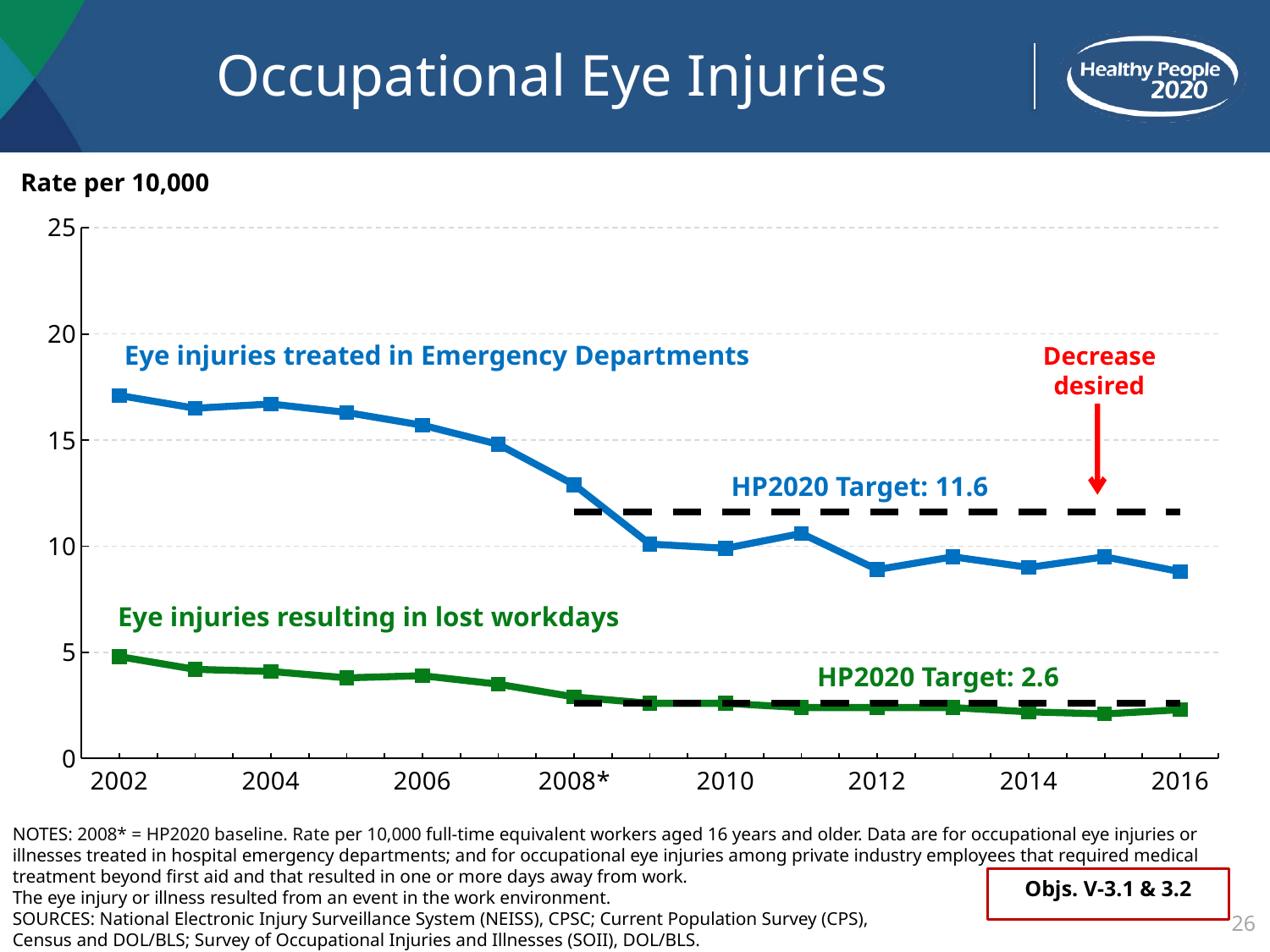
In which year is the rate of eye injuries resulting in lost workdays highest? 2002 What is the title of the chart on the slide? Occupational Eye Injuries Is the 2002 value for eye injuries treated in Emergency Departments greater or less than 15? greater How many years (data points) are plotted for each series, from 2002 to 2016? 15 What is the HP2020 target for eye injuries treated in Emergency Departments? 11.6 Which is larger: the rate of eye injuries treated in Emergency Departments in 2002 or in 2016? 2002 In which year is the rate of eye injuries treated in Emergency Departments highest? 2002 Is the 2016 value for eye injuries treated in Emergency Departments greater or less than 10? less What kind of chart is shown on the slide? line chart Does the rate of eye injuries treated in Emergency Departments generally rise or fall from 2002 to 2016? fall What is the HP2020 target for eye injuries resulting in lost workdays? 2.6 How many data series are plotted on the chart? 2